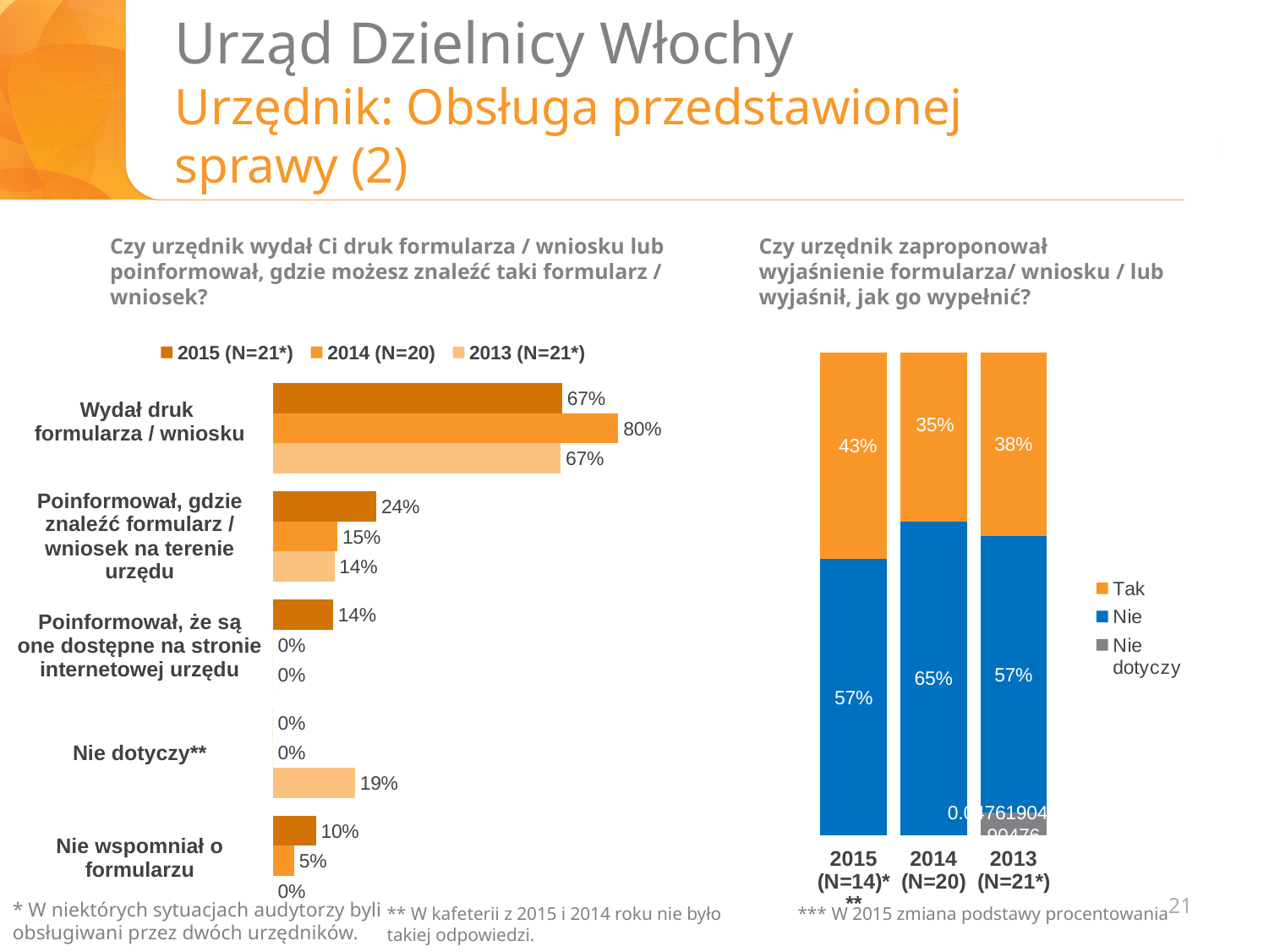
In the left chart, what is the 2015 (N=21*) value for 'Poinformował, gdzie znaleźć formularz / wniosek na terenie urzędu'? 24% How many series does the legend of the right chart list? 3 What type of chart is the left chart? Bar chart In the right chart, what is the 'Nie' share for 2014 (N=20)? 65% In the right chart (Czy urzędnik zaproponował wyjaśnienie formularza...), what is the 'Tak' share for 2015 (N=14)*? 43% In the left chart (Czy urzędnik wydał Ci druk formularza...), what is the 2014 (N=20) value for 'Wydał druk formularza / wniosku'? 80% How many categories are shown in the left chart? 5 In the left chart, what is the 2013 (N=21*) value for 'Nie dotyczy**'? 19% In the right chart, which year has the lowest 'Tak' share? 2014 (N=20) How many series does the legend of the left chart list? 3 In the left chart, which year has the highest value for 'Wydał druk formularza / wniosku'? 2014 (N=20) In the left chart, what is the difference between the 2014 and 2015 values for 'Wydał druk formularza / wniosku'? 13 percentage points